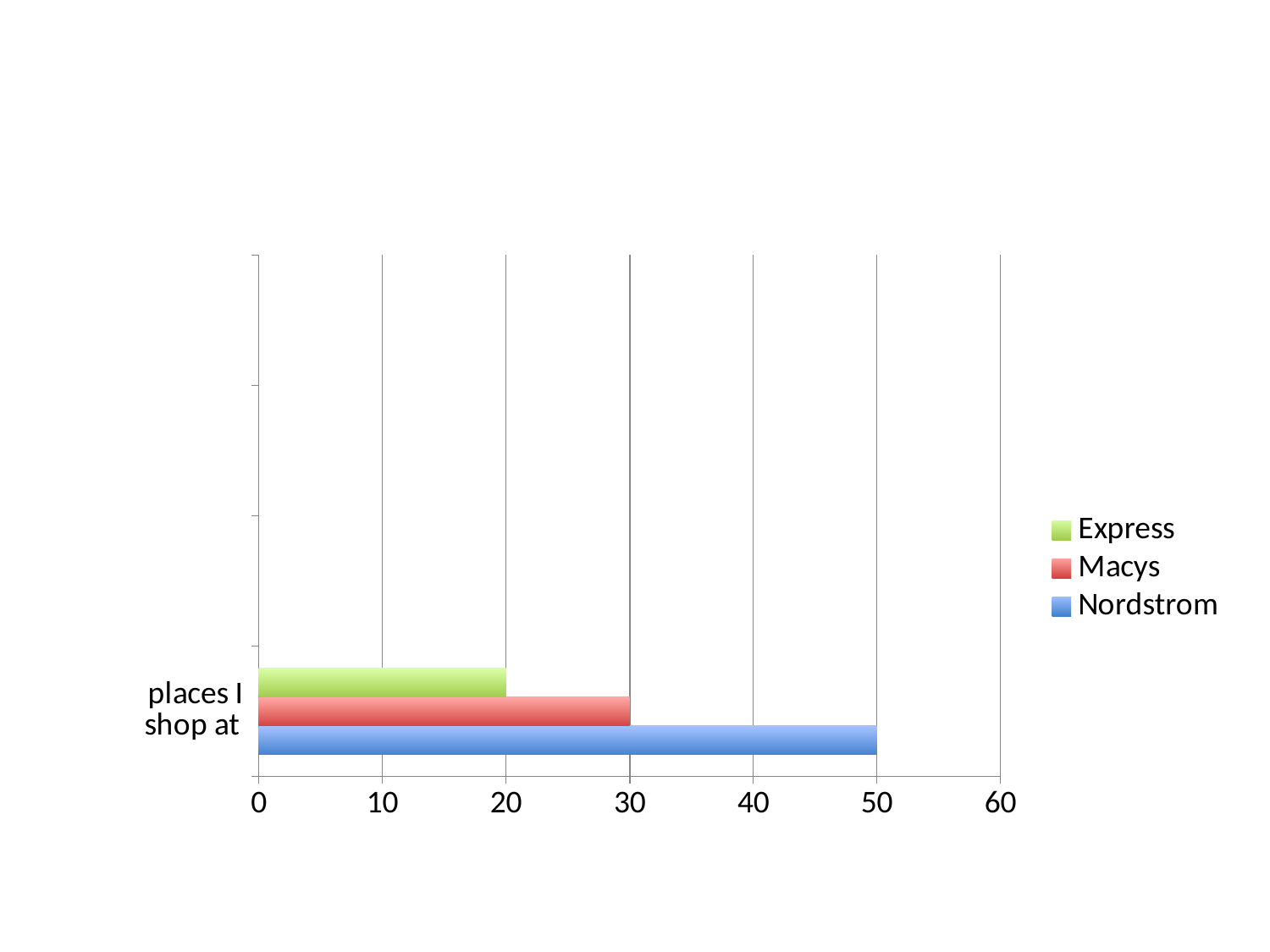
What colour is the bar for Express? green Which series has the lowest value? Express Which series has the highest value? Nordstrom What is the value for Nordstrom? 50 What kind of chart is shown on the slide? bar chart What is the difference between the values for Nordstrom and Macys? 20 Is the value for Nordstrom greater or less than 40? greater Which is larger, the value for Macys or the value for Express? Macys How many series does the legend list? 3 What is the value for Macys? 30 What is the value for Express? 20 What is the label of the category on the vertical axis? places I shop at